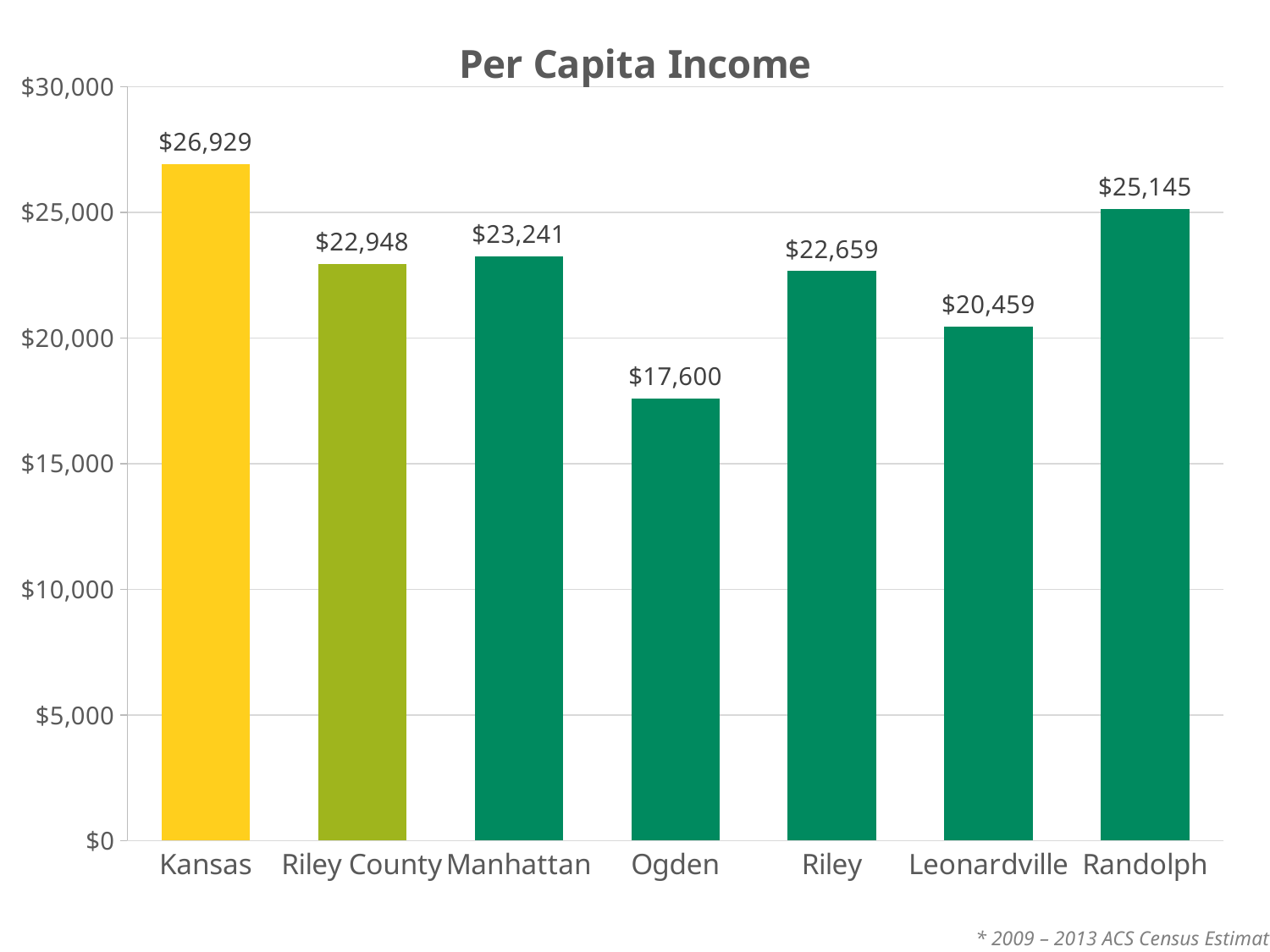
What is the per capita income for Ogden? $17,600 What is the per capita income for Leonardville? $20,459 Which category has the highest per capita income? Kansas How many categories are shown in the chart? 7 What is the difference between the per capita income of Randolph and Ogden? $7,545 What is the title of the chart? Per Capita Income What kind of chart is shown on the slide? Bar chart What is the difference between the per capita income of Kansas and Riley County? $3,981 What is the per capita income for Randolph? $25,145 Which category has the lowest per capita income? Ogden Which has a higher per capita income, Manhattan or Leonardville? Manhattan What is the per capita income for Kansas? $26,929